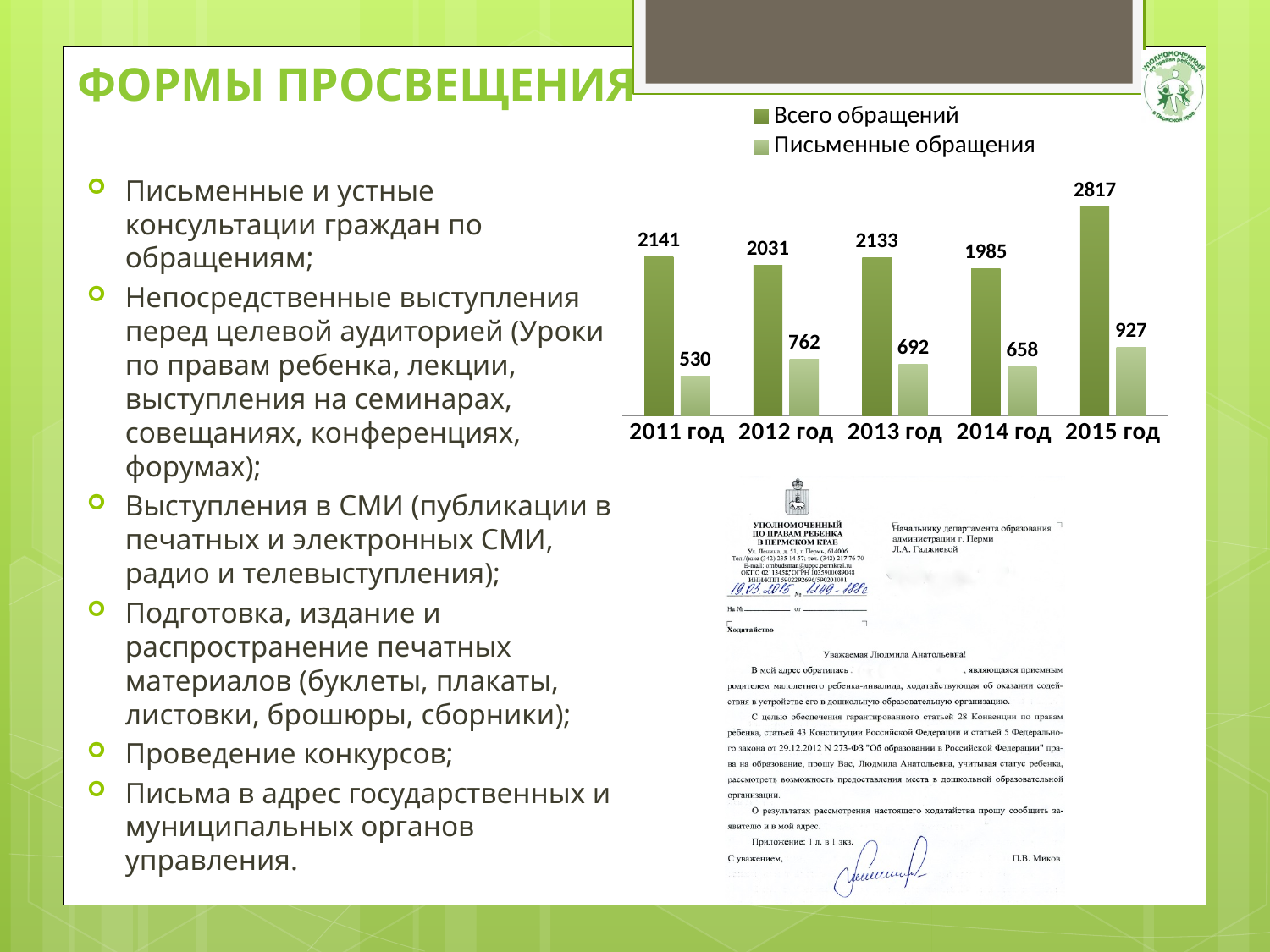
How many series does the legend list? 2 Which series is shown in the lighter green colour? Письменные обращения What kind of chart is shown on the slide? bar chart Which is larger: "Письменные обращения" in 2012 год or in 2014 год? 2012 год What is the value for "Всего обращений" in 2015 год? 2817 What is the difference between "Всего обращений" and "Письменные обращения" in 2012 год? 1269 How many years are shown on the x axis? 5 In which year is "Всего обращений" lowest? 2014 год In which year is "Всего обращений" highest? 2015 год What is the value for "Письменные обращения" in 2011 год? 530 In which year is "Письменные обращения" lowest? 2011 год What is the value for "Письменные обращения" in 2013 год? 692